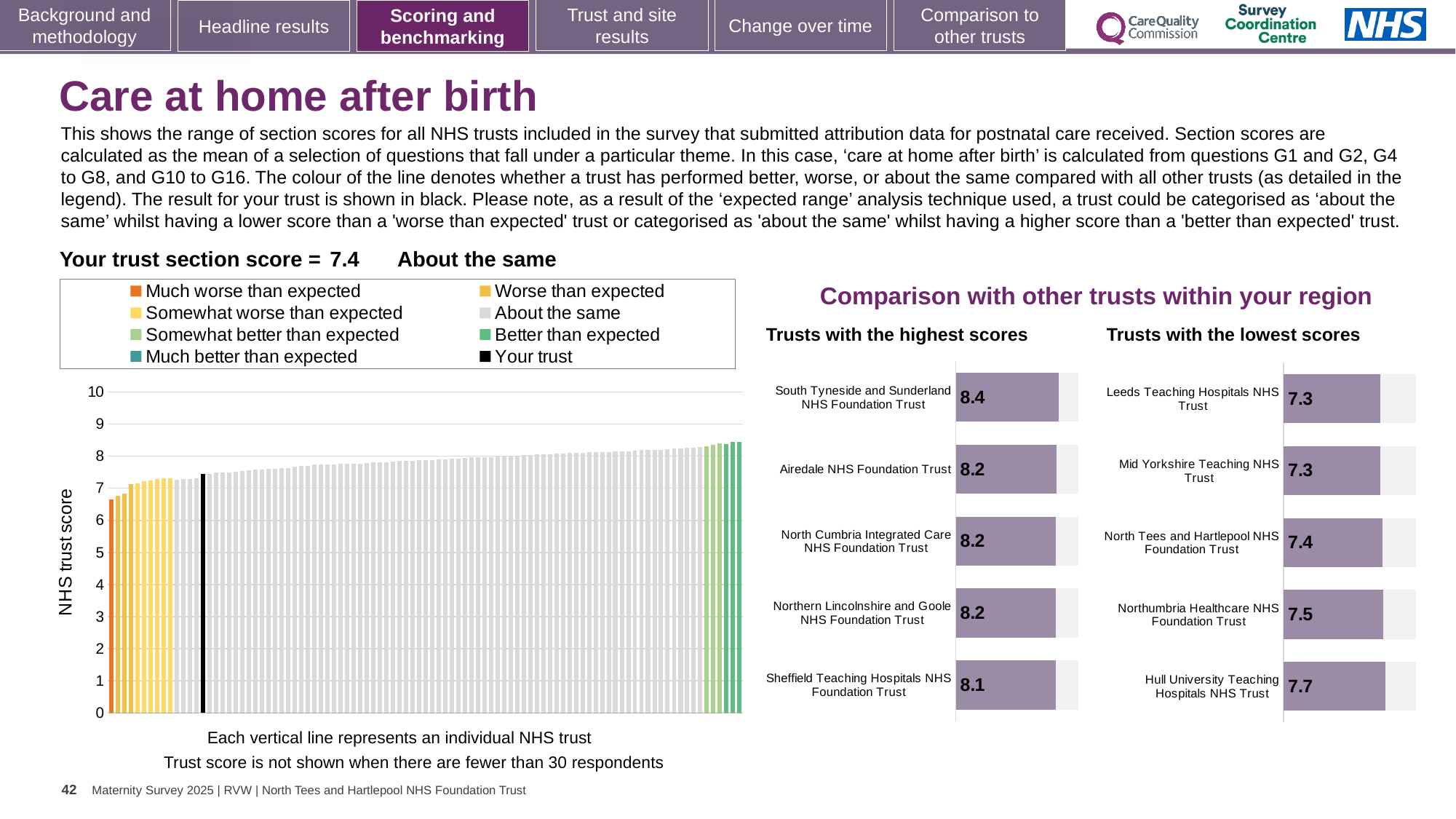
In the 'Trusts with the lowest scores' chart, what is the score for North Tees and Hartlepool NHS Foundation Trust? 7.4 In the 'Trusts with the lowest scores' chart, which has the larger score: Northumbria Healthcare NHS Foundation Trust or North Tees and Hartlepool NHS Foundation Trust? Northumbria Healthcare NHS Foundation Trust In the 'Trusts with the highest scores' chart, what is the score for South Tyneside and Sunderland NHS Foundation Trust? 8.4 In the 'Trusts with the highest scores' chart, which trust has the highest score? South Tyneside and Sunderland NHS Foundation Trust In the 'Trusts with the lowest scores' chart, what is the difference between the scores of Hull University Teaching Hospitals NHS Trust and Leeds Teaching Hospitals NHS Trust? 0.4 In the 'Trusts with the lowest scores' chart, which trust has the highest score? Hull University Teaching Hospitals NHS Trust In the 'Trusts with the highest scores' chart, what is the score for Sheffield Teaching Hospitals NHS Foundation Trust? 8.1 How many trusts are shown in the 'Trusts with the highest scores' chart? 5 In the NHS trust score chart on the left, do the trust scores rise or fall from left to right? rise How many entries does the legend of the NHS trust score chart on the left list? 8 In the 'Trusts with the highest scores' chart, what is the difference between the scores of South Tyneside and Sunderland NHS Foundation Trust and Sheffield Teaching Hospitals NHS Foundation Trust? 0.3 In the 'Trusts with the lowest scores' chart, what is the score for Hull University Teaching Hospitals NHS Trust? 7.7